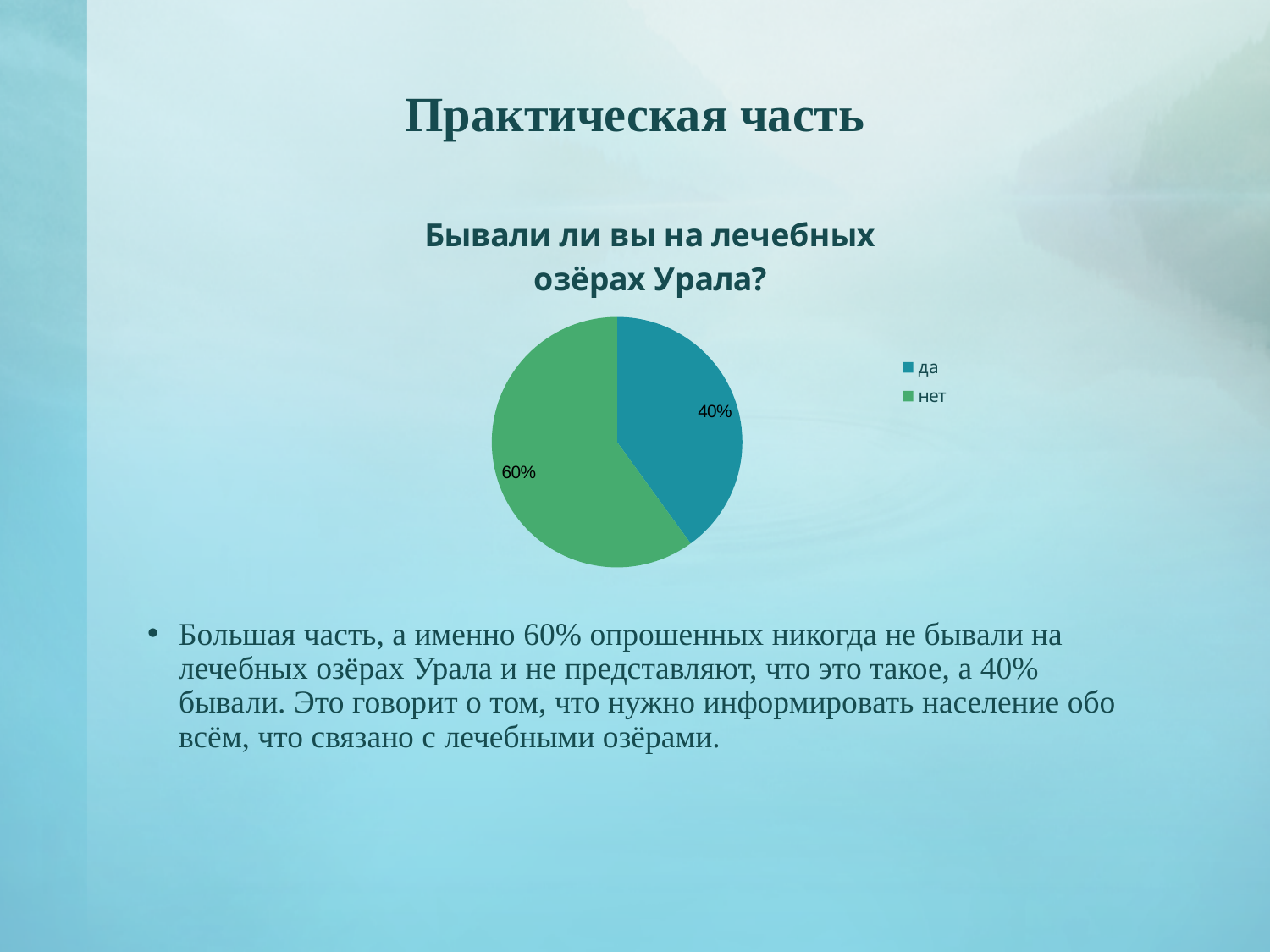
How many entries does the legend list? 2 What is the difference between the "нет" share and the "да" share? 20% What colour is the "нет" slice? green What kind of chart is shown on the slide? pie chart What is the title of the chart? Бывали ли вы на лечебных озёрах Урала? Which is larger, the "да" slice or the "нет" slice? нет How many categories does the pie chart have? 2 Which category has the smallest slice of the pie? да Which category has the largest slice of the pie? нет What share of the pie does the "нет" slice represent? 60% What share of the pie does the "да" slice represent? 40%